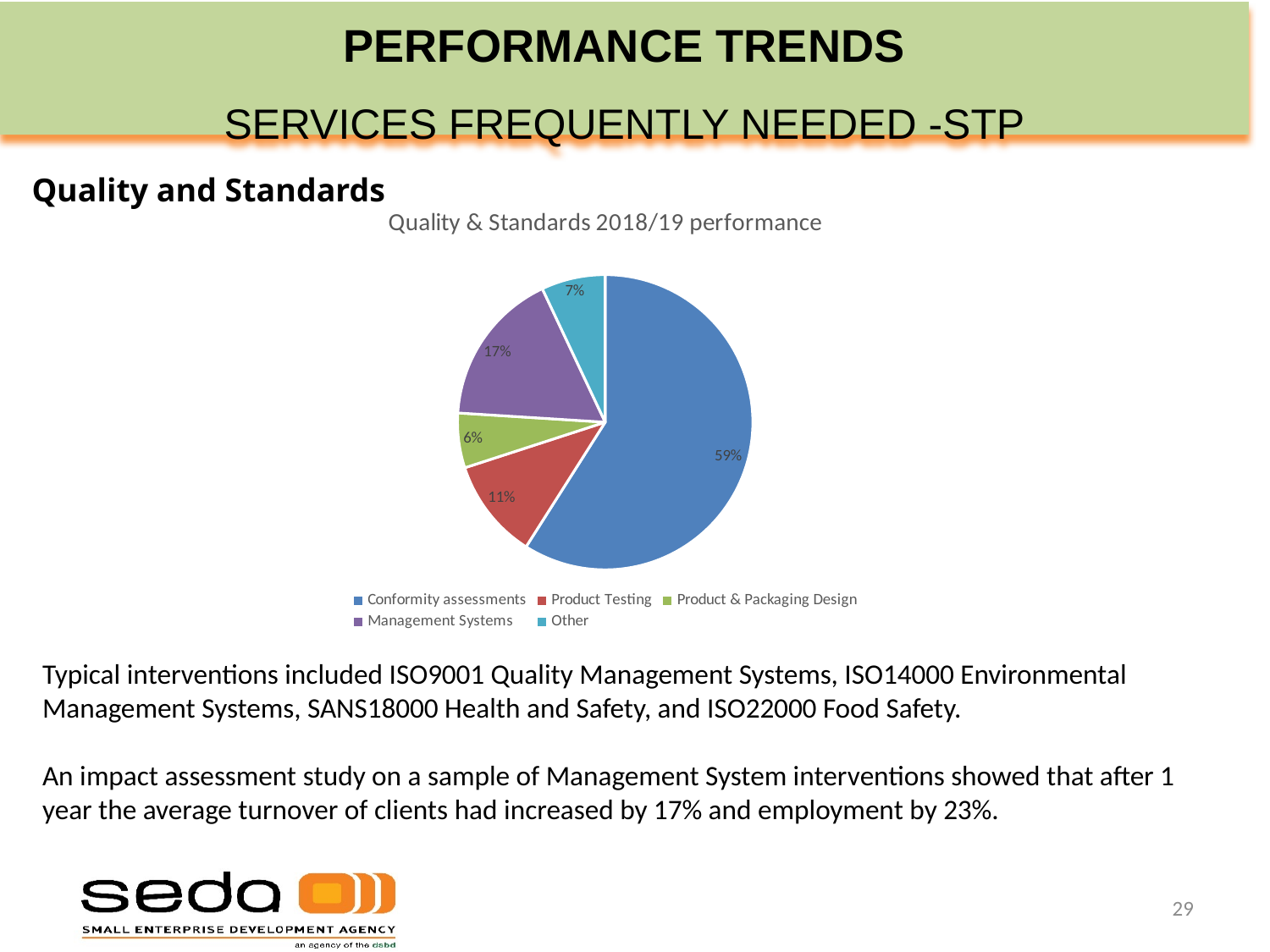
How many categories does the legend list? 5 What share of the pie is Product & Packaging Design? 6% What kind of chart is shown on the slide? Pie chart What share of the pie is Product Testing? 11% Which category has the largest slice of the pie? Conformity assessments What share of the pie is Other? 7% What is the title of the chart? Quality & Standards 2018/19 performance Which is larger, the slice for Other or the slice for Product & Packaging Design? Other Which category has the smallest slice of the pie? Product & Packaging Design What is the difference in percentage points between Management Systems and Product Testing? 6